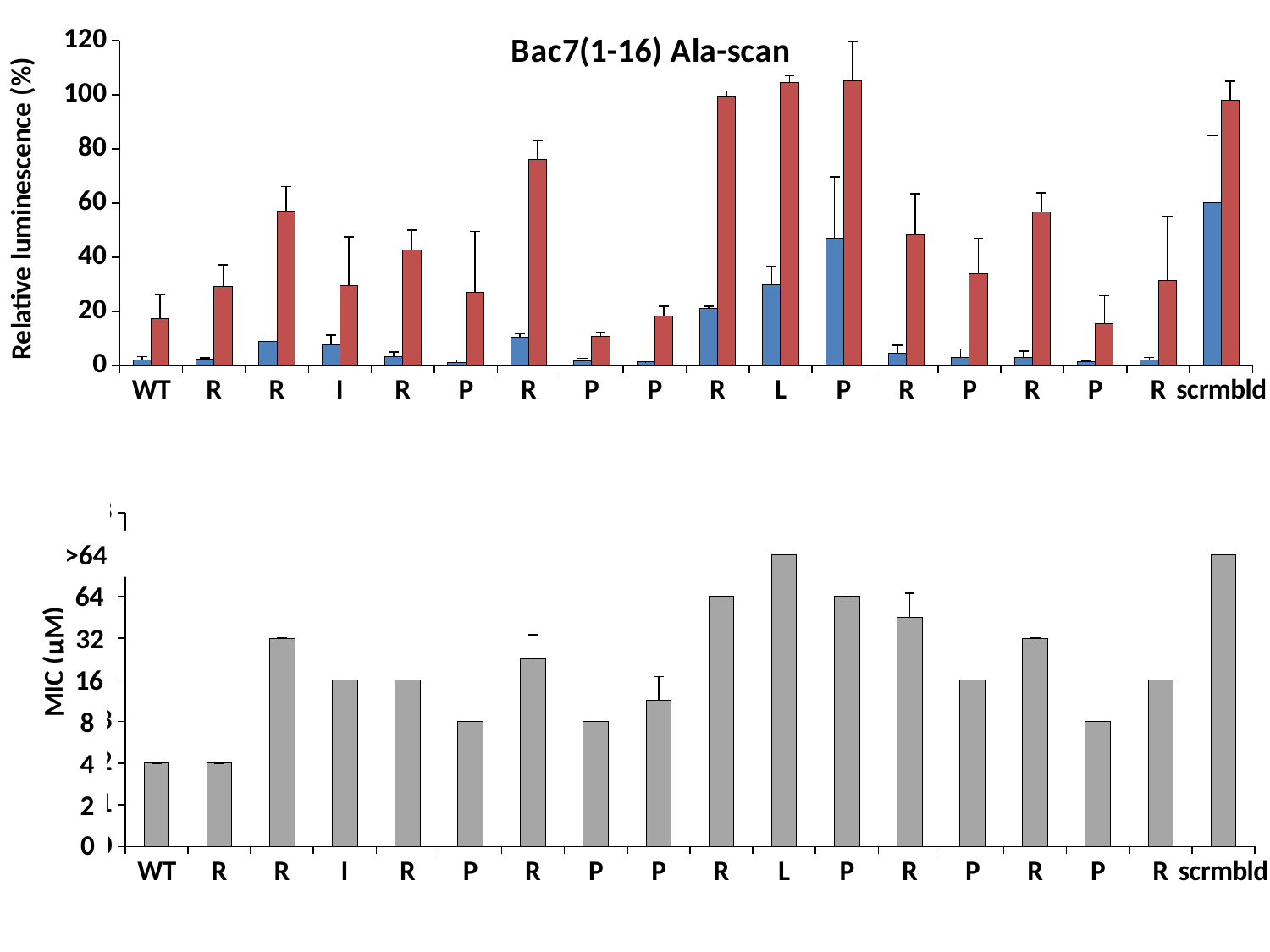
What is the title of the top chart? Bac7(1-16) Ala-scan In the bottom chart (MIC (uM)), which has the larger MIC value, WT or I? I In the top chart (Bac7(1-16) Ala-scan), is the red bar for I greater or less than 40? less In the top chart (Bac7(1-16) Ala-scan), is the red bar for L greater or less than 100? greater In the bottom chart (MIC (uM)), what is the MIC value for L? >64 In the bottom chart (MIC (uM)), what is the MIC value for scrmbld? >64 In the top chart (Bac7(1-16) Ala-scan), which has the larger red bar, WT or L? L How many categories are shown on the x axis of the bottom chart (MIC (uM))? 18 In the bottom chart (MIC (uM)), what is the difference between the MIC values for I and WT? 12 In the bottom chart (MIC (uM)), what is the MIC value for WT? 4 What type of chart is the bottom chart (MIC (uM))? bar chart In the bottom chart (MIC (uM)), what is the MIC value for I? 16